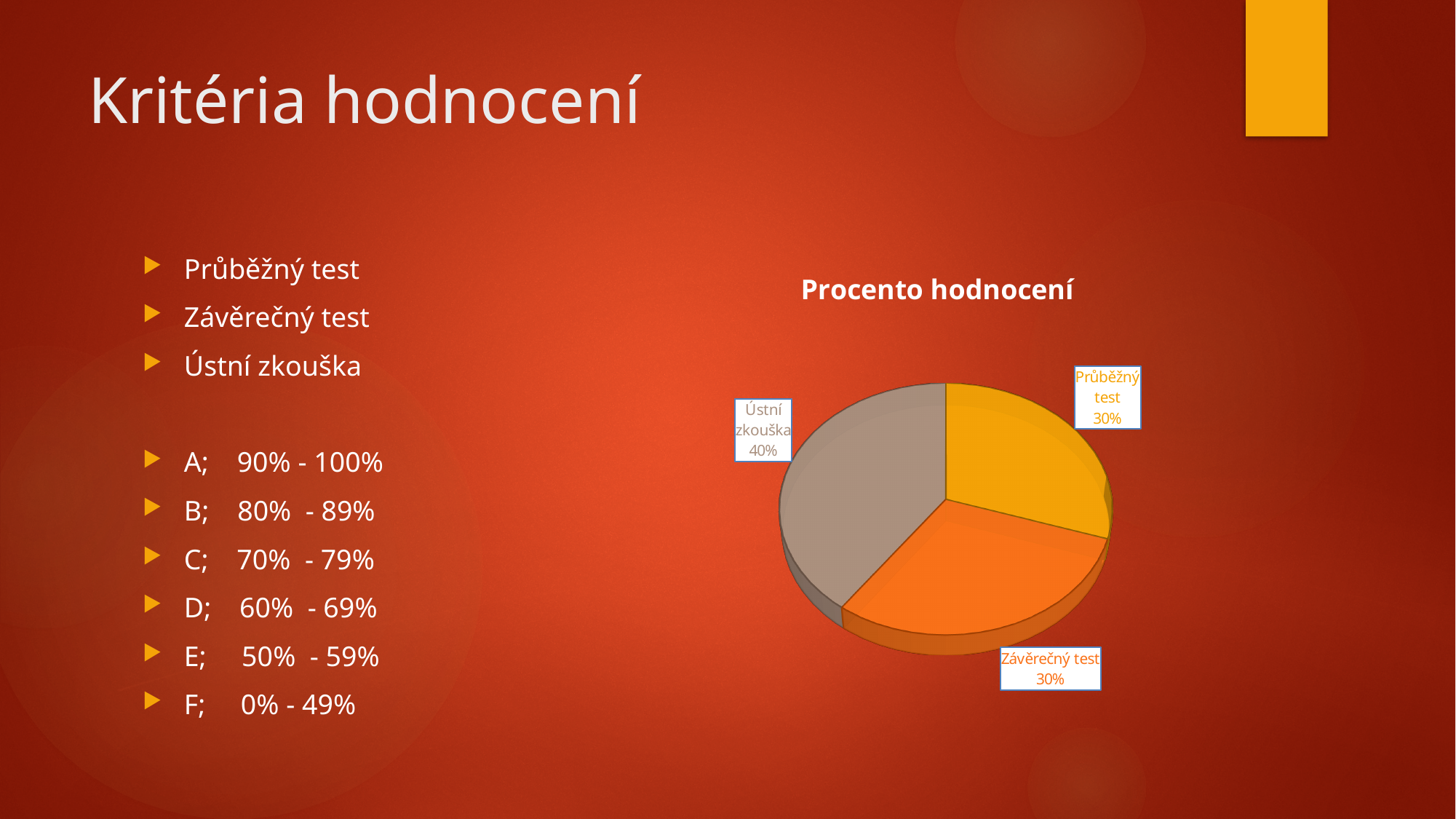
Which is larger, the share of Ústní zkouška or the share of Závěrečný test? Ústní zkouška What share of the pie does Průběžný test have? 30% What colour is the Ústní zkouška slice? grey Which category has the largest slice of the pie? Ústní zkouška What is the difference between the share of Ústní zkouška and the share of Průběžný test? 10% What is the title of the chart? Procento hodnocení What share of the pie does Ústní zkouška have? 40% What share of the pie does Závěrečný test have? 30% What kind of chart is shown on the slide? pie chart What is the combined share of Průběžný test and Závěrečný test? 60% How many slices does the pie chart have? 3